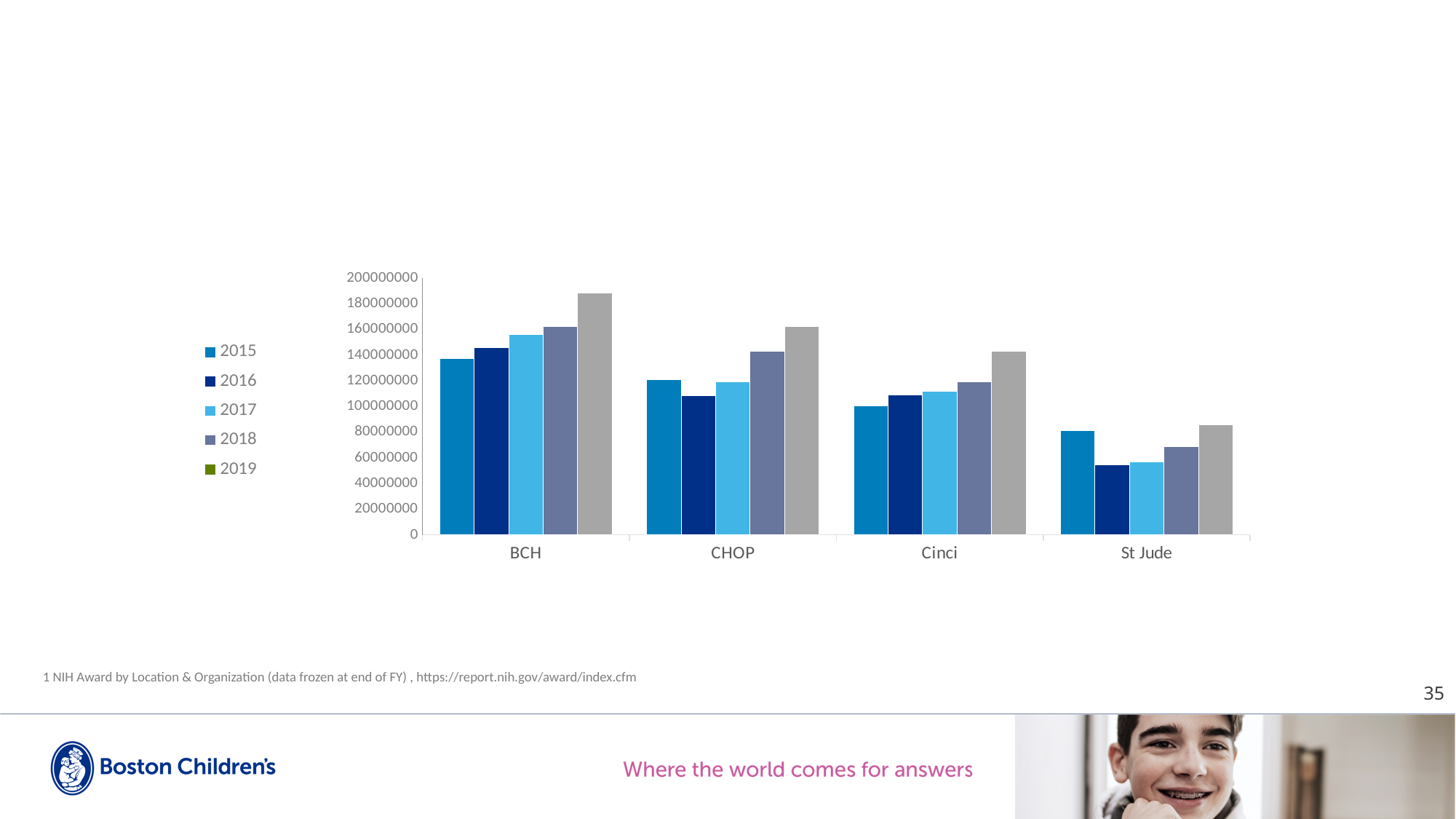
How many categories are shown on the x axis of the chart? 4 Do the values for BCH rise or fall from 2015 to 2019? rise Which category has the tallest bar in the chart? BCH Which series is shown in dark navy in the legend? 2016 What kind of chart is shown on the slide? bar chart Is the 2016 value for CHOP greater or less than 100000000? greater Which category has the shortest bar in the chart? St Jude Is the 2019 value for St Jude greater or less than 80000000? greater Which is larger, the 2015 value for BCH or the 2015 value for CHOP? BCH How many series does the chart's legend list? 5 Is the 2019 value for BCH greater or less than 180000000? greater